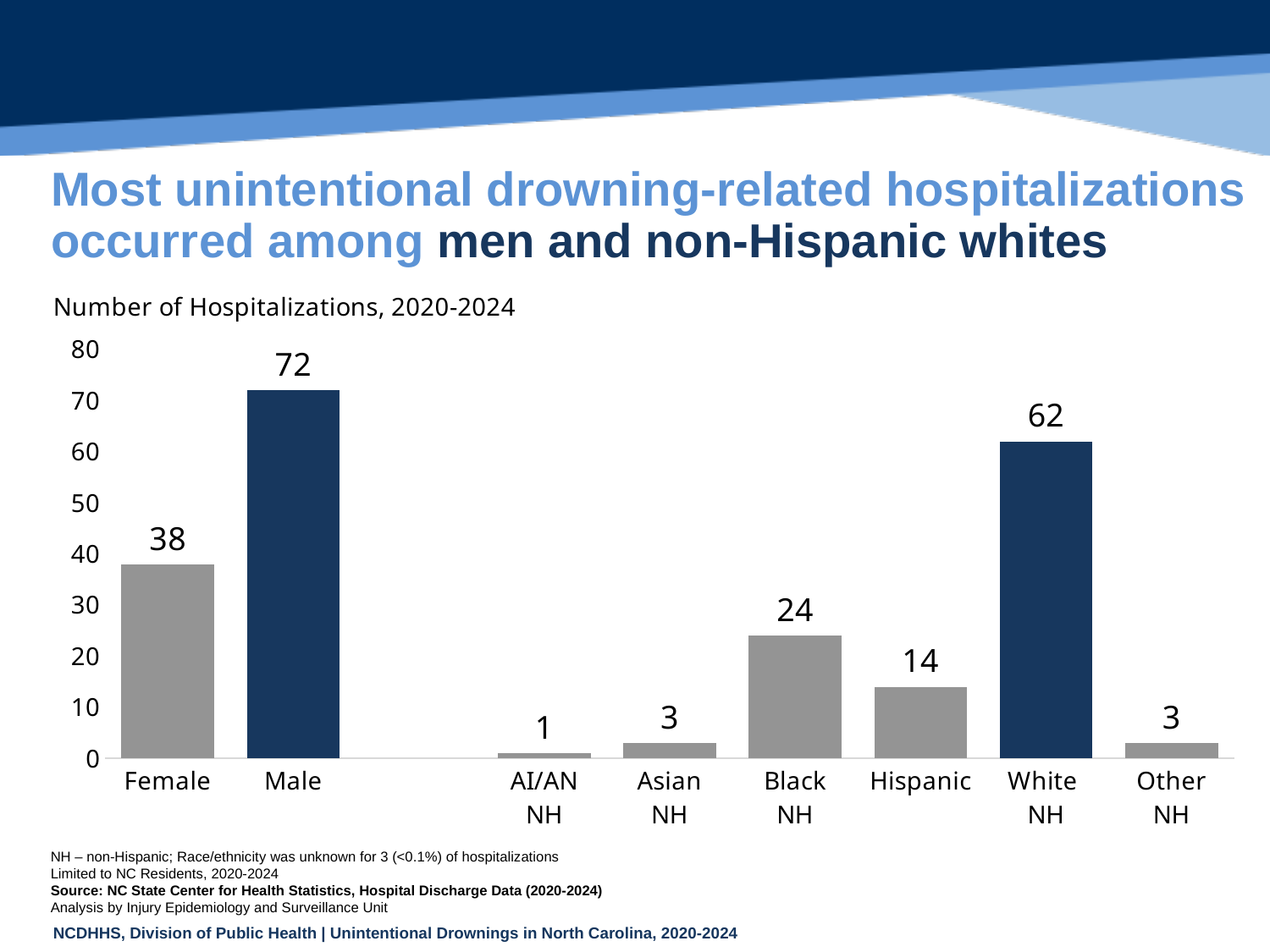
Which race/ethnicity category has the highest number of hospitalizations? White NH What is the number of hospitalizations for Hispanic? 14 What is the subtitle shown above the chart? Number of Hospitalizations, 2020-2024 Which has more hospitalizations, Black NH or Hispanic? Black NH What kind of chart is shown on the slide? Bar chart What is the number of hospitalizations for Male? 72 What is the difference in hospitalizations between White NH and Black NH? 38 How many categories are shown on the x axis? 8 What is the number of hospitalizations for Female? 38 What is the number of hospitalizations for Black NH? 24 What is the difference in hospitalizations between Male and Female? 34 Which category has the lowest number of hospitalizations? AI/AN NH